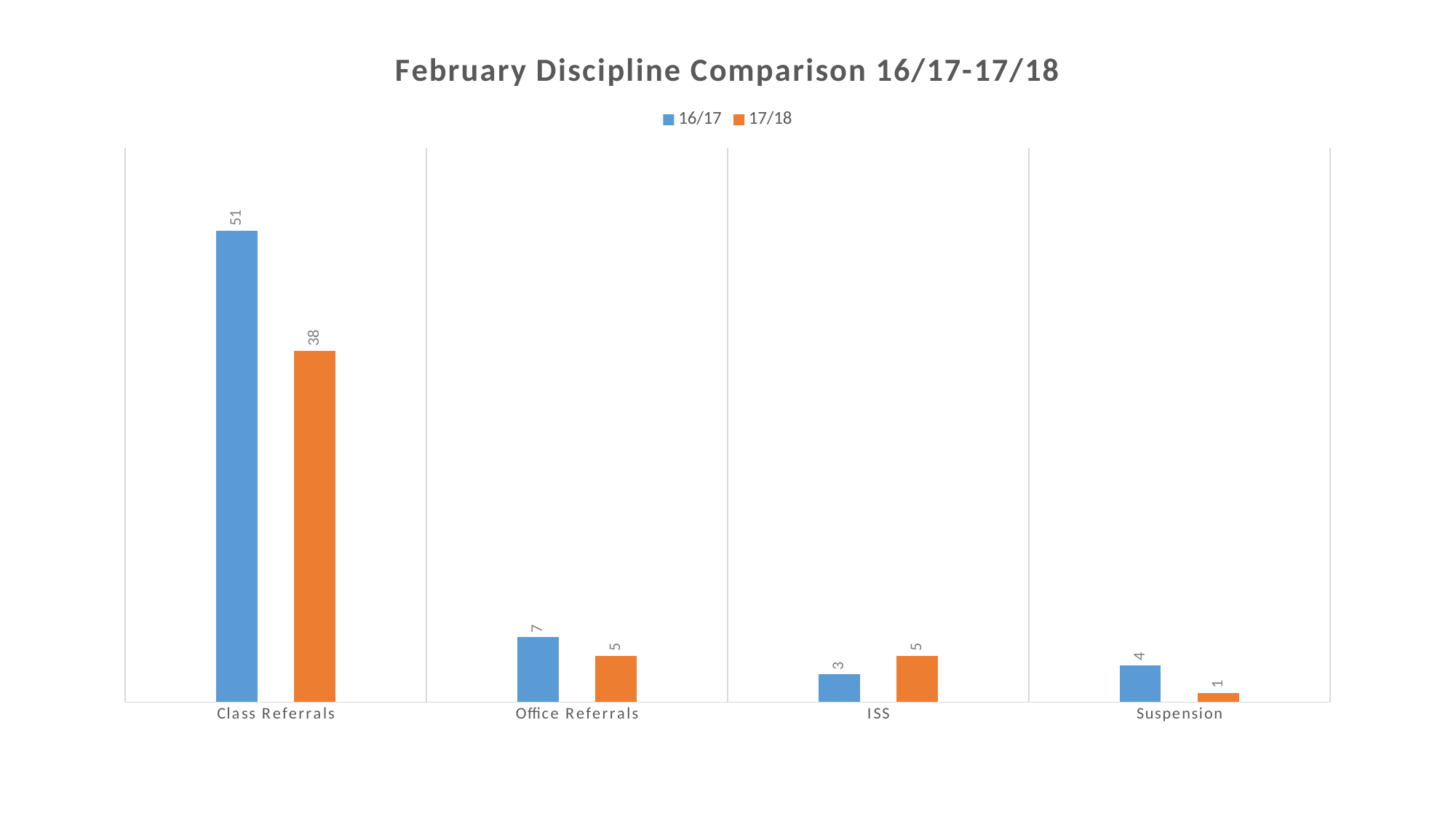
What is the 16/17 value for Class Referrals? 51 What is the 16/17 value for Suspension? 4 What is the difference between the 16/17 and 17/18 values for Class Referrals? 13 Which category has the lowest 17/18 value? Suspension How many series does the legend list? 2 What is the title of the chart? February Discipline Comparison 16/17-17/18 What kind of chart is shown on the slide? Bar chart For ISS, which series has the larger value, 16/17 or 17/18? 17/18 Which category has the highest 16/17 value? Class Referrals What is the 17/18 value for Class Referrals? 38 What is the 17/18 value for Office Referrals? 5 How many categories are shown on the x axis? 4